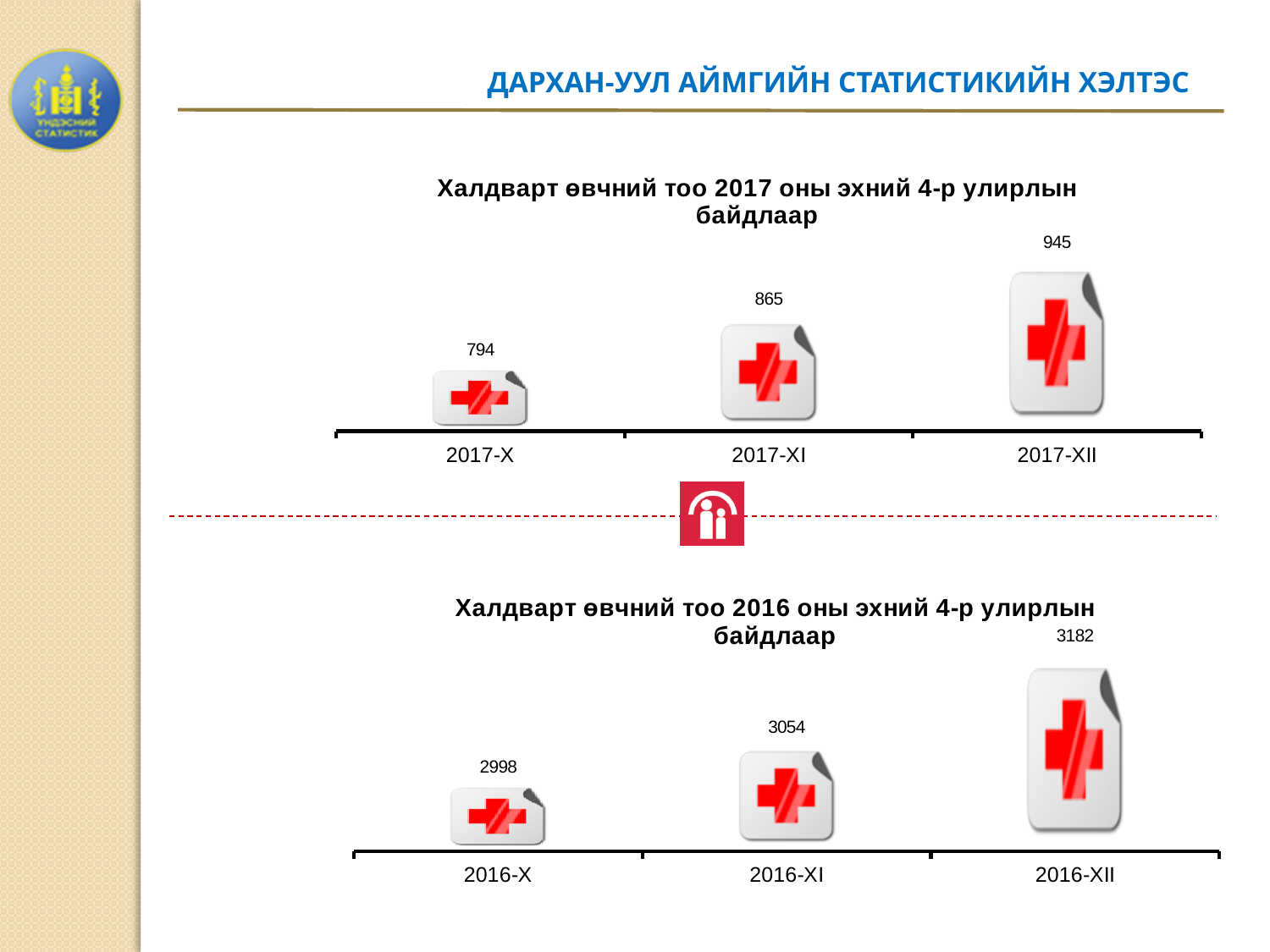
In the bottom chart (2016), what is the difference between the values for 2016-XI and 2016-X? 56 In the top chart (2017), do the values rise or fall from 2017-X to 2017-XII? rise In the bottom chart (2016), which month has the lowest value? 2016-X In the top chart (2017), what is the value for 2017-X? 794 In the top chart (2017), what is the difference between the values for 2017-XII and 2017-XI? 80 In the top chart (2017), which month has the highest value? 2017-XII In the bottom chart (2016), how many months are shown on the x axis? 3 In the top chart (2017), what is the value for 2017-XII? 945 In the bottom chart (2016), what is the value for 2016-XII? 3182 Which is larger: the value for 2017-XII in the top chart or the value for 2016-X in the bottom chart? 2016-X In the top chart (2017), which month has the lowest value? 2017-X In the bottom chart (2016), what is the value for 2016-XI? 3054